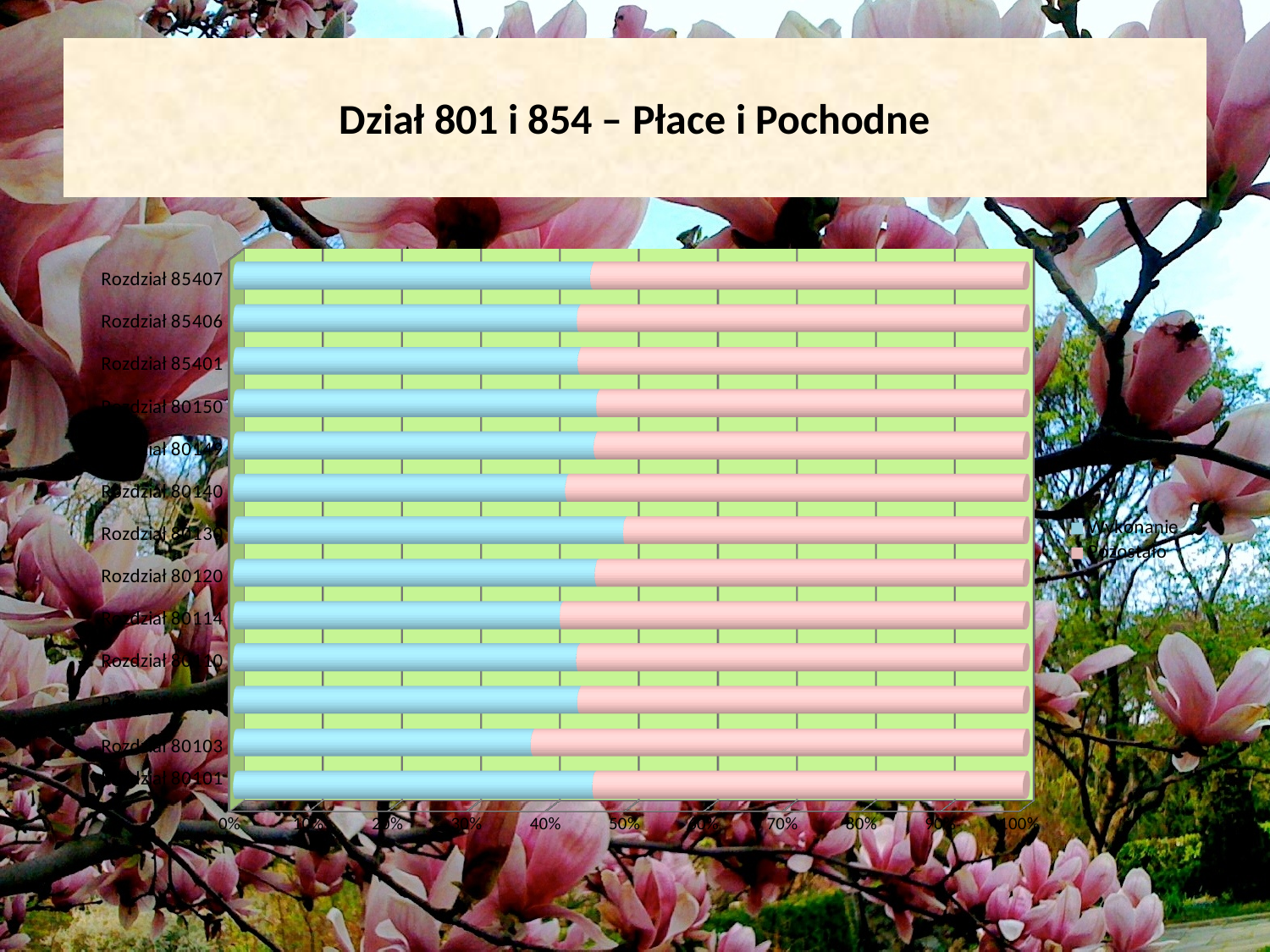
Which category has the lowest Wykonanie share? Rozdział 80103 What is the title of the slide containing the chart? Dział 801 i 854 – Płace i Pochodne Is the Wykonanie value for Rozdział 85407 greater or less than 50%? less Is the Wykonanie value for Rozdział 80120 greater or less than 40%? greater What are the two series named in the legend? Wykonanie and Pozostało Is the Wykonanie value for Rozdział 80103 greater or less than 40%? less What kind of chart is shown on the slide? bar chart Which has the larger Wykonanie share, Rozdział 85407 or Rozdział 80103? Rozdział 85407 How many bars (categories) are plotted in the chart? 13 How many series does the legend list? 2